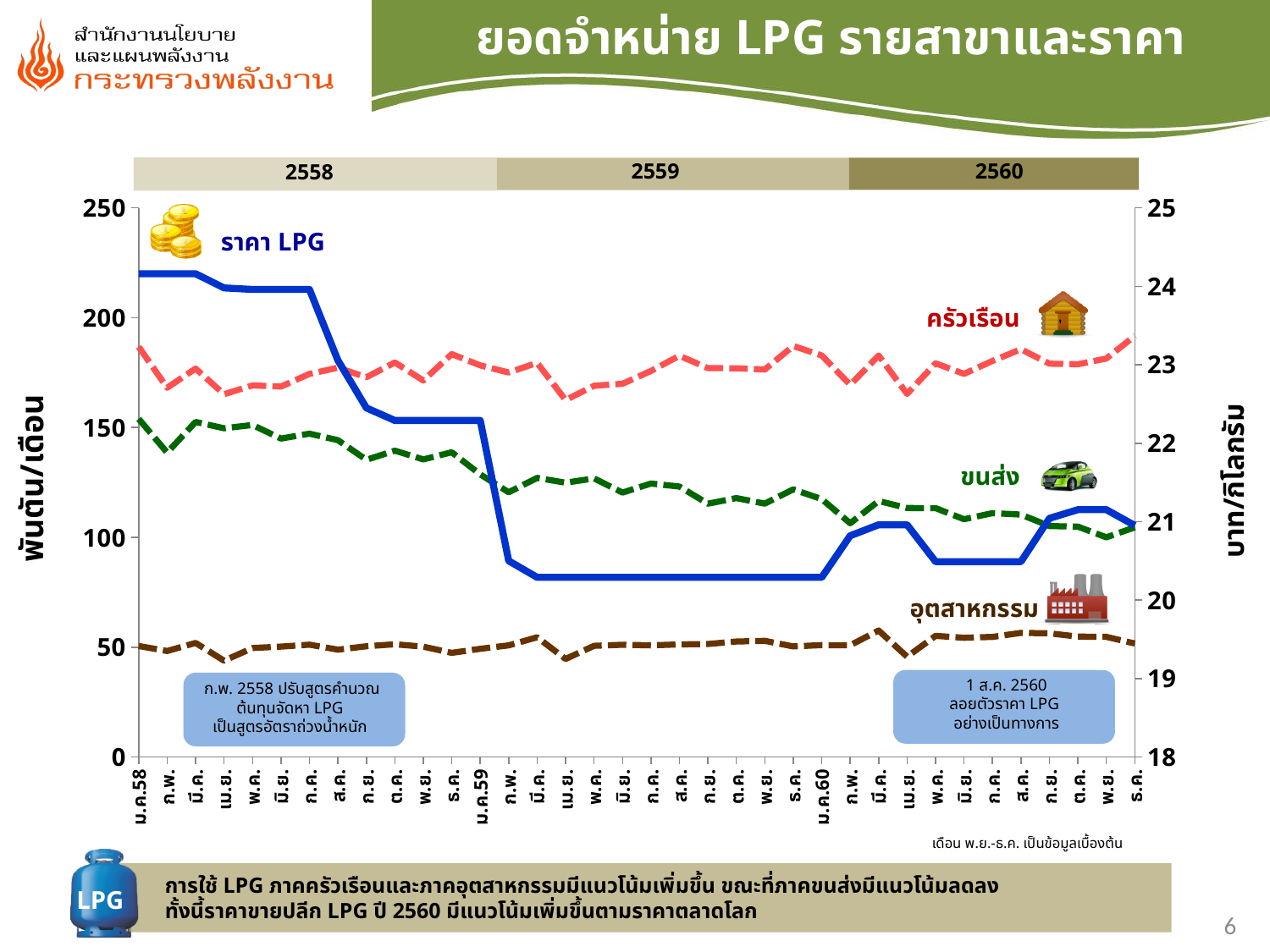
What is the label of the right-hand vertical axis? บาท/กิโลกรัม Is the ราคา LPG value in มี.ค.59 greater or less than 21 on the right axis? less Which series has the highest value on the left axis in ธ.ค.60? ครัวเรือน What kind of chart is shown on the slide? line chart Is the value for อุตสาหกรรม in ม.ค.58 greater or less than 100? less Is the value for ขนส่ง in ธ.ค.60 greater or less than 150? less Which is larger in ม.ค.60, ขนส่ง or อุตสาหกรรม? ขนส่ง What is the title of the chart? ยอดจำหน่าย LPG รายสาขาและราคา How many data series are plotted on the chart? 4 Does the ขนส่ง series generally rise or fall from ม.ค.58 to ธ.ค.60? fall